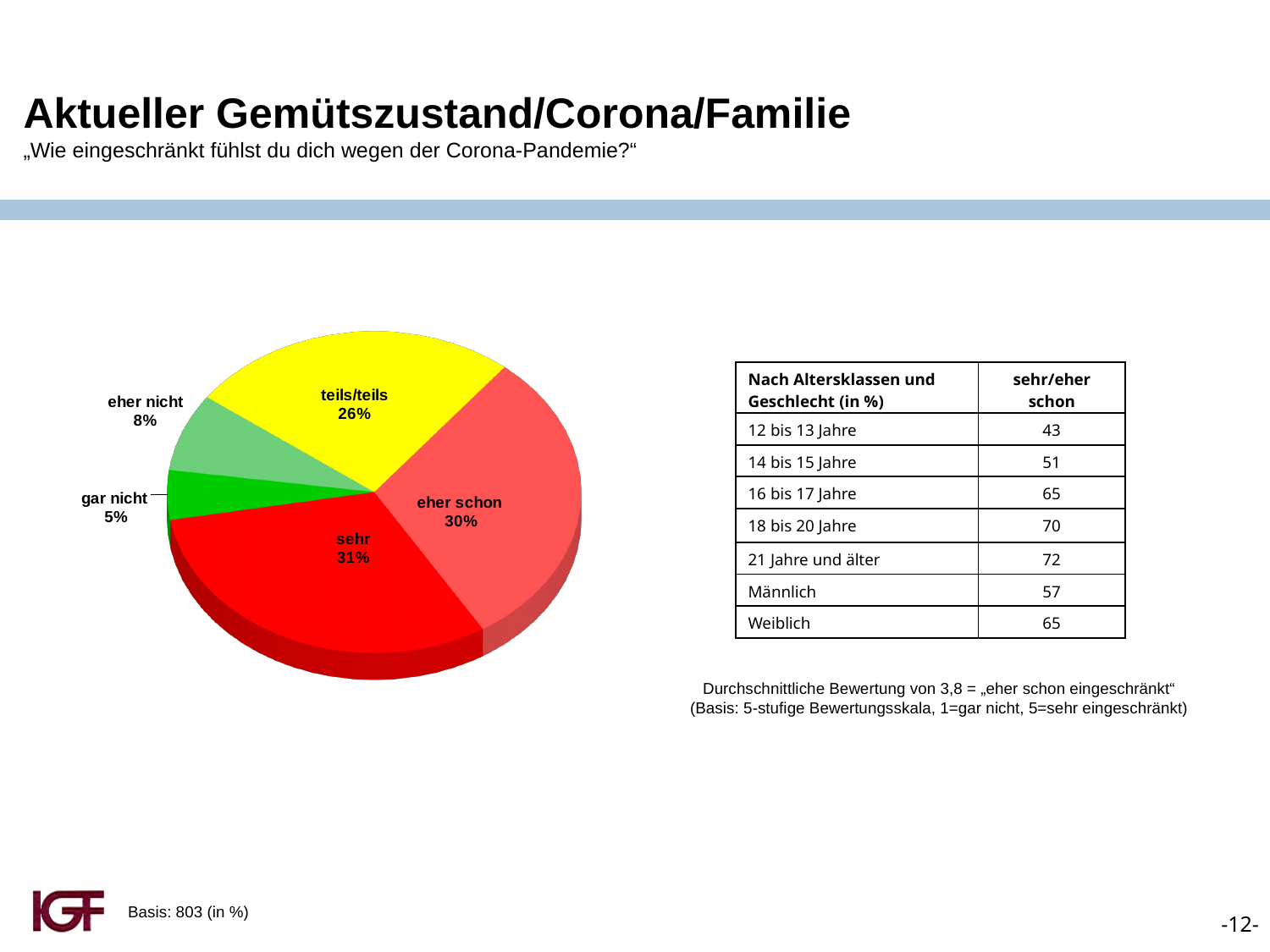
What share of the pie does "sehr" take? 31% What is the difference between the values for "sehr" and "teils/teils"? 5% What is the value shown for "gar nicht"? 5% What kind of chart is shown on the slide? pie chart Which slice of the pie chart is the largest? sehr Which slice of the pie chart is the smallest? gar nicht What is the value shown for "teils/teils"? 26% Which is larger, the value for "teils/teils" or the value for "eher nicht"? teils/teils How many slices does the pie chart have? 5 What is the difference between the values for "eher nicht" and "gar nicht"? 3% What is the value shown for "eher schon"? 30% What colour is the "teils/teils" slice of the pie chart? yellow